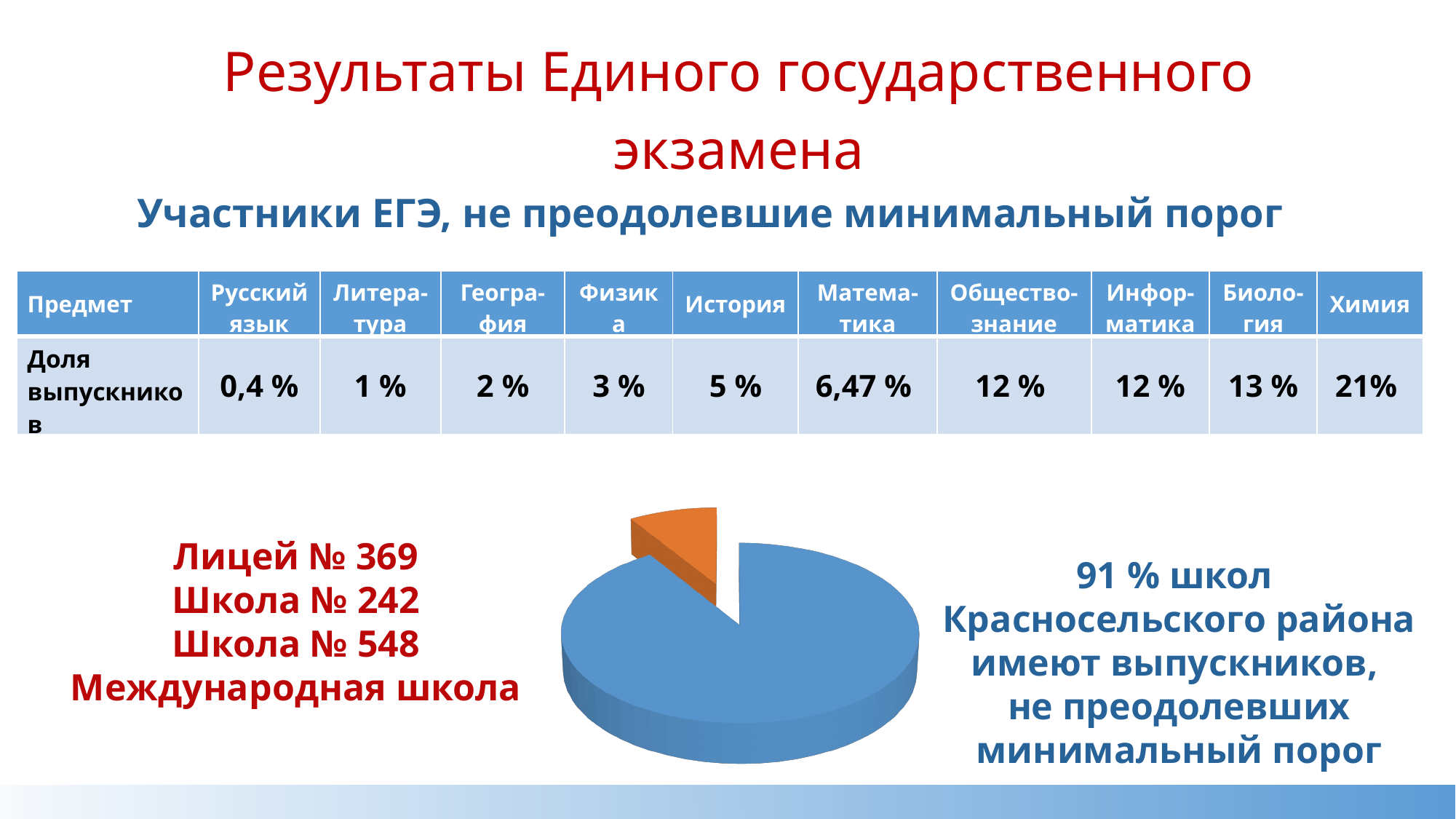
What kind of chart is shown at the bottom of the slide? pie chart Which slice of the pie chart is the smallest? the orange slice Is the orange slice of the pie chart greater or less than 25% of the pie? less Is the blue slice of the pie chart greater or less than 50% of the pie? greater Does the pie chart display a legend? No Which slice of the pie chart is larger, the blue one or the orange one? the blue one How many slices does the pie chart have? 2 What two colours are used for the slices of the pie chart? blue and orange